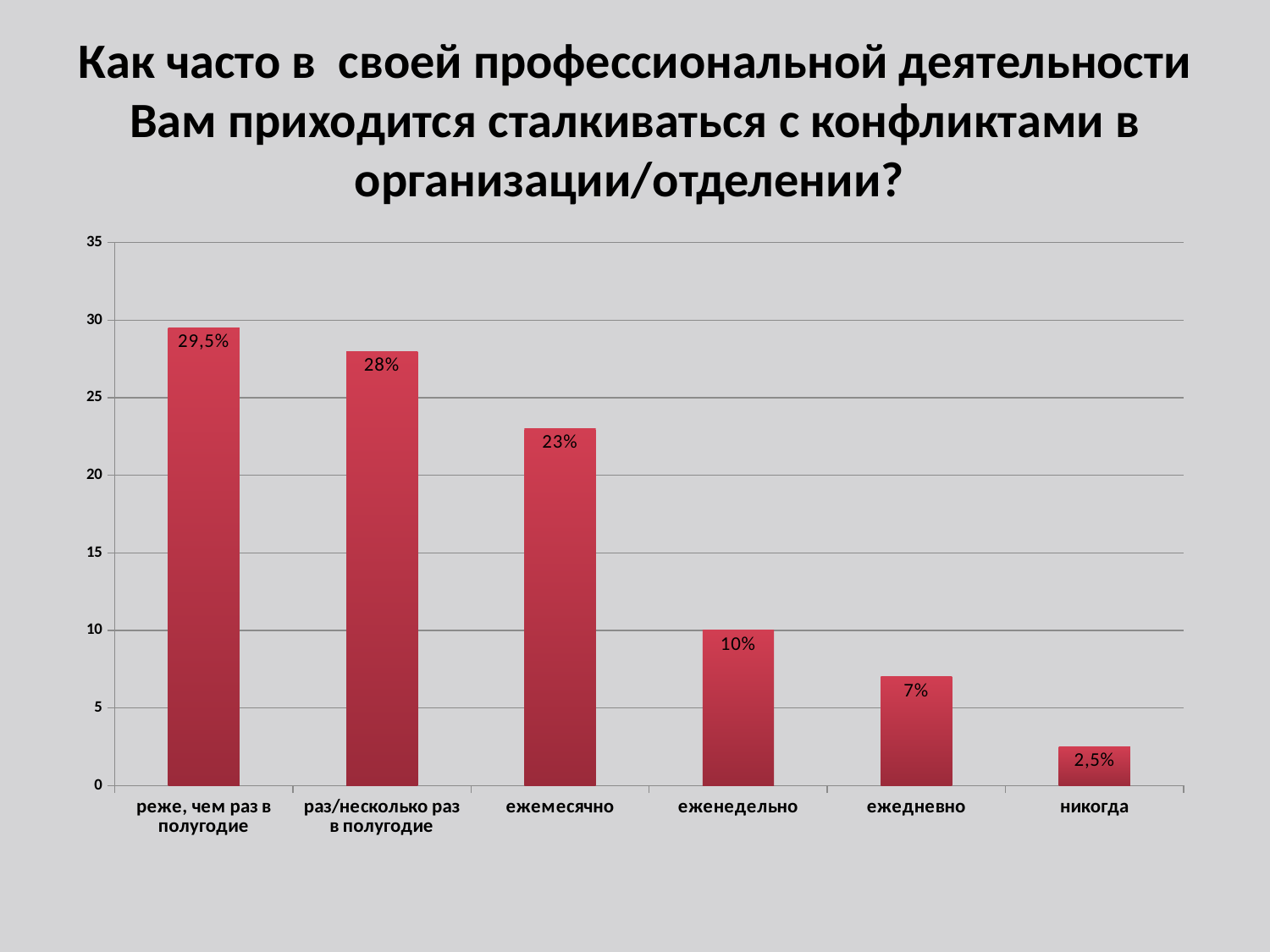
What is the value for «никогда»? 2,5% Which category has the lowest value? никогда Is the value for «раз/несколько раз в полугодие» greater or less than 25? greater Which category has the highest value? реже, чем раз в полугодие What is the value for «еженедельно»? 10% What kind of chart is shown on the slide? bar chart What is the difference between the values for «ежемесячно» and «ежедневно»? 16% Do the values rise or fall from left to right along the x axis? fall What is the difference between the values for «реже, чем раз в полугодие» and «раз/несколько раз в полугодие»? 1,5% What is the value for «ежемесячно»? 23% How many categories are shown on the x axis? 6 Which is larger: the value for «еженедельно» or the value for «ежедневно»? еженедельно